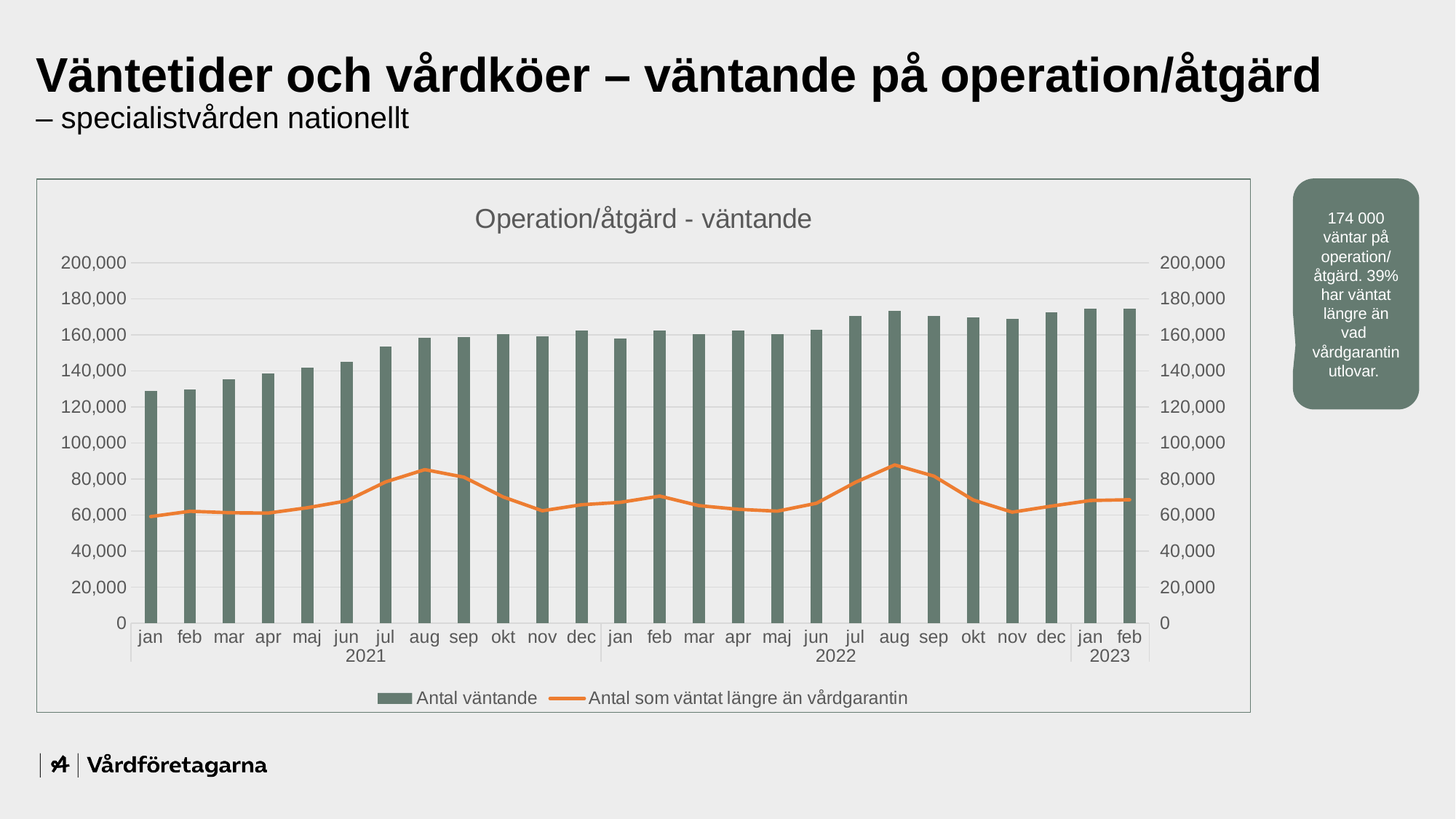
How many series does the legend of the chart list? 2 Which is larger, the Antal som väntat längre än vårdgarantin value for aug 2021 or for nov 2021? aug 2021 Which is larger, the Antal väntande bar for jan 2021 or for dec 2022? dec 2022 Is the Antal som väntat längre än vårdgarantin value for aug 2021 greater or less than 80,000? greater Is the Antal väntande value for aug 2022 greater or less than 160,000? greater How many months are plotted along the x axis of the chart? 26 What kind of chart is shown on the slide? A combined bar and line chart What is the title of the chart? Operation/åtgärd - väntande Is the Antal väntande value for jan 2021 greater or less than 140,000? less Do the bars for Antal väntande generally rise or fall from jan 2021 to feb 2023? Rise Which series is drawn as an orange line in the chart? Antal som väntat längre än vårdgarantin Which month has the lowest bar for Antal väntande? jan 2021